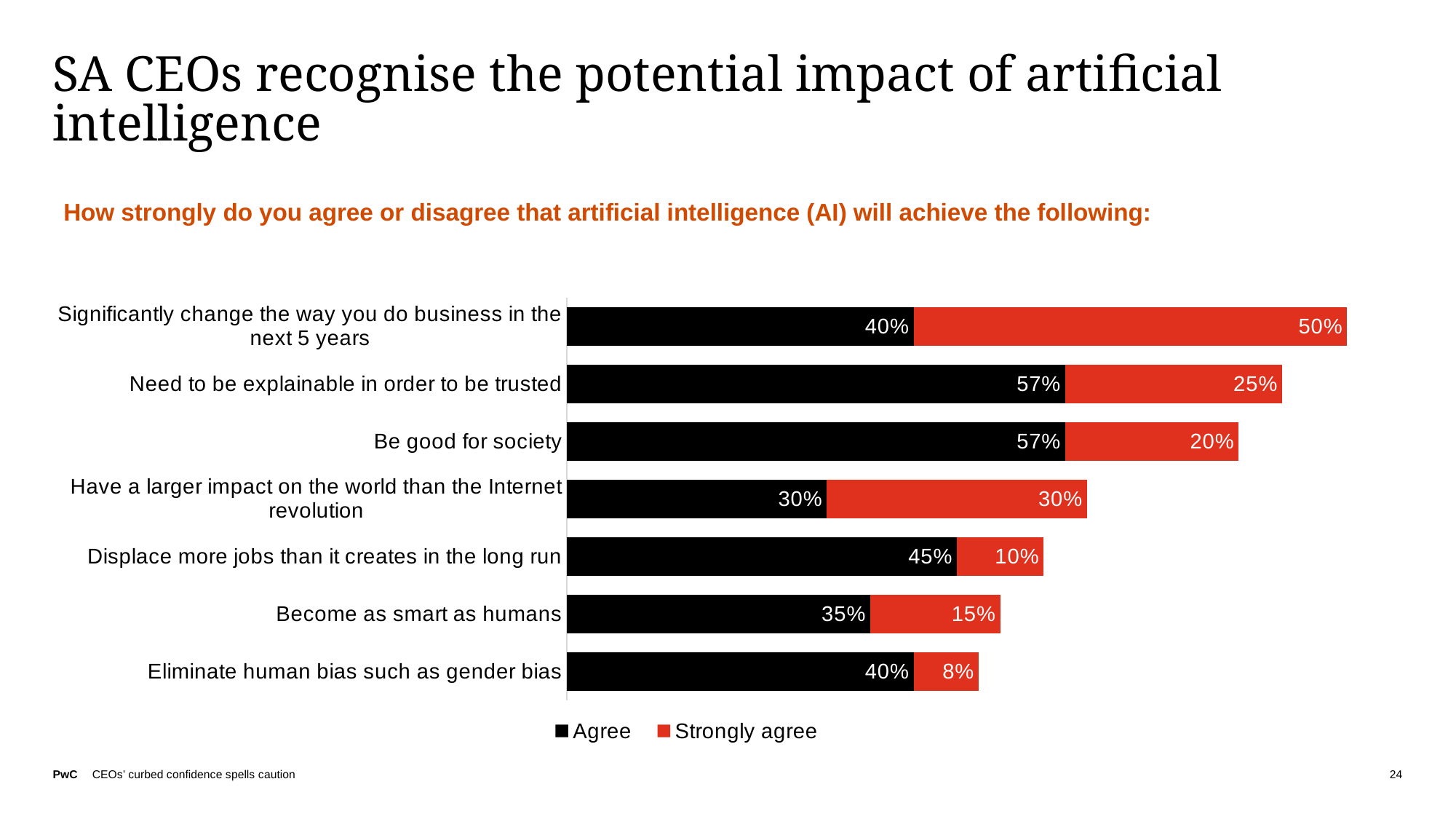
Which colour represents 'Strongly agree' in the chart? Red What is the difference between the 'Agree' and 'Strongly agree' values for 'Displace more jobs than it creates in the long run'? 35% What is the 'Strongly agree' value for 'Eliminate human bias such as gender bias'? 8% How many series does the legend list? 2 How many statements are shown in the chart? 7 What is the 'Strongly agree' value for 'Need to be explainable in order to be trusted'? 25% What is the combined total of 'Agree' and 'Strongly agree' for 'Be good for society'? 77% What type of chart is shown on the slide? Stacked bar chart Which is larger: the 'Agree' value for 'Become as smart as humans' or the 'Agree' value for 'Displace more jobs than it creates in the long run'? Displace more jobs than it creates in the long run Which statement has the lowest 'Strongly agree' value? Eliminate human bias such as gender bias Which statement has the highest 'Strongly agree' value? Significantly change the way you do business in the next 5 years What percentage of CEOs 'Agree' that AI will significantly change the way they do business in the next 5 years? 40%